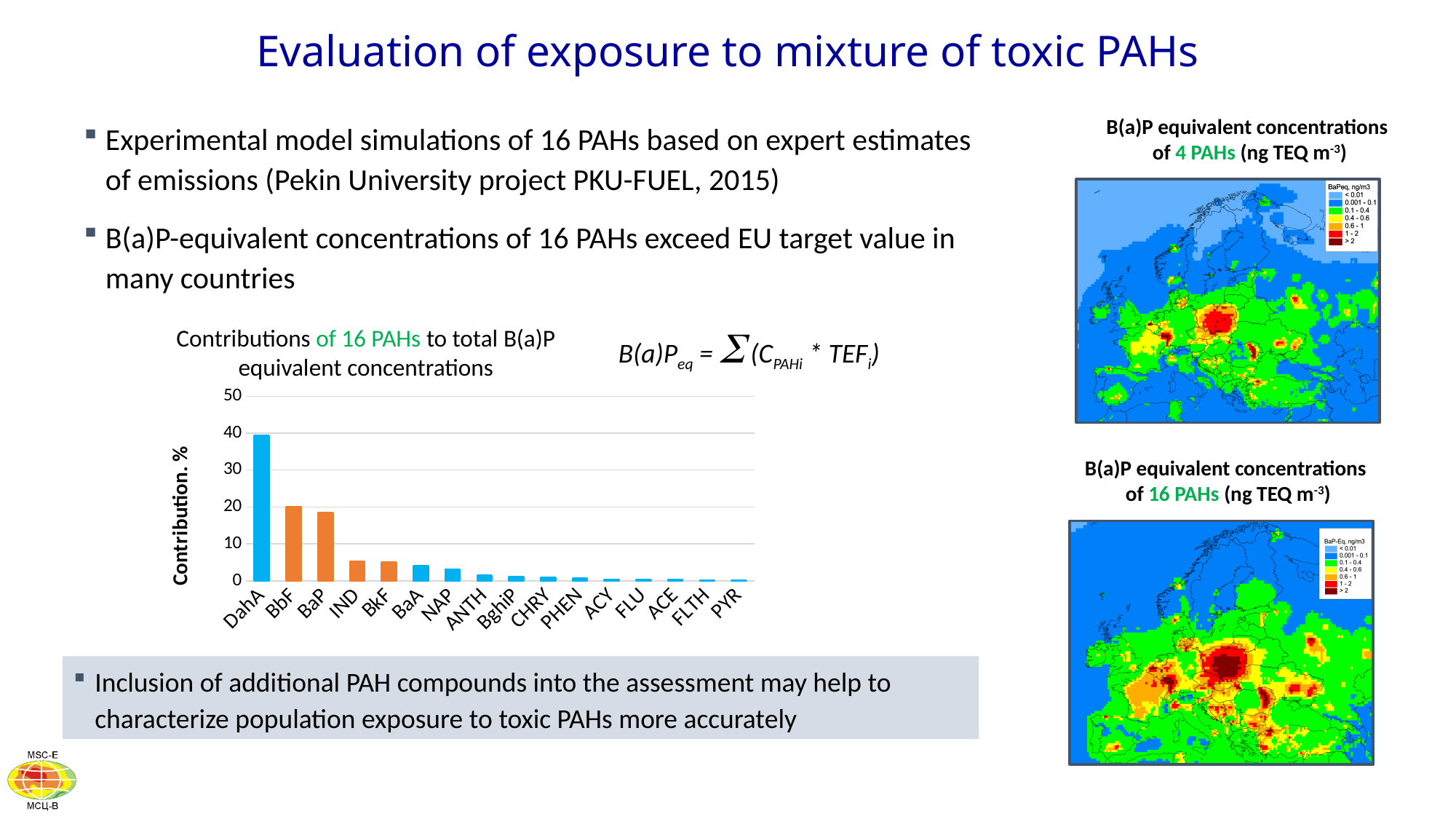
Do the bar values in the contributions chart rise or fall moving from left to right along the x axis? Fall In the contributions chart, is the value for NAP greater or less than 10? less In the contributions chart, is the value for DahA greater or less than 30? greater In the contributions chart, which has a larger contribution, DahA or BbF? DahA In the contributions chart, is the value for BaP greater or less than 10? greater Which PAH has the highest contribution to total B(a)P equivalent concentrations in the bar chart? DahA What is the label of the y axis in the contributions chart? Contribution, % What kind of chart is used to show the contributions of 16 PAHs to total B(a)P equivalent concentrations? Bar chart How many PAH categories are plotted on the x axis of the contributions chart? 16 In the contributions chart, which has a larger contribution, BbF or IND? BbF